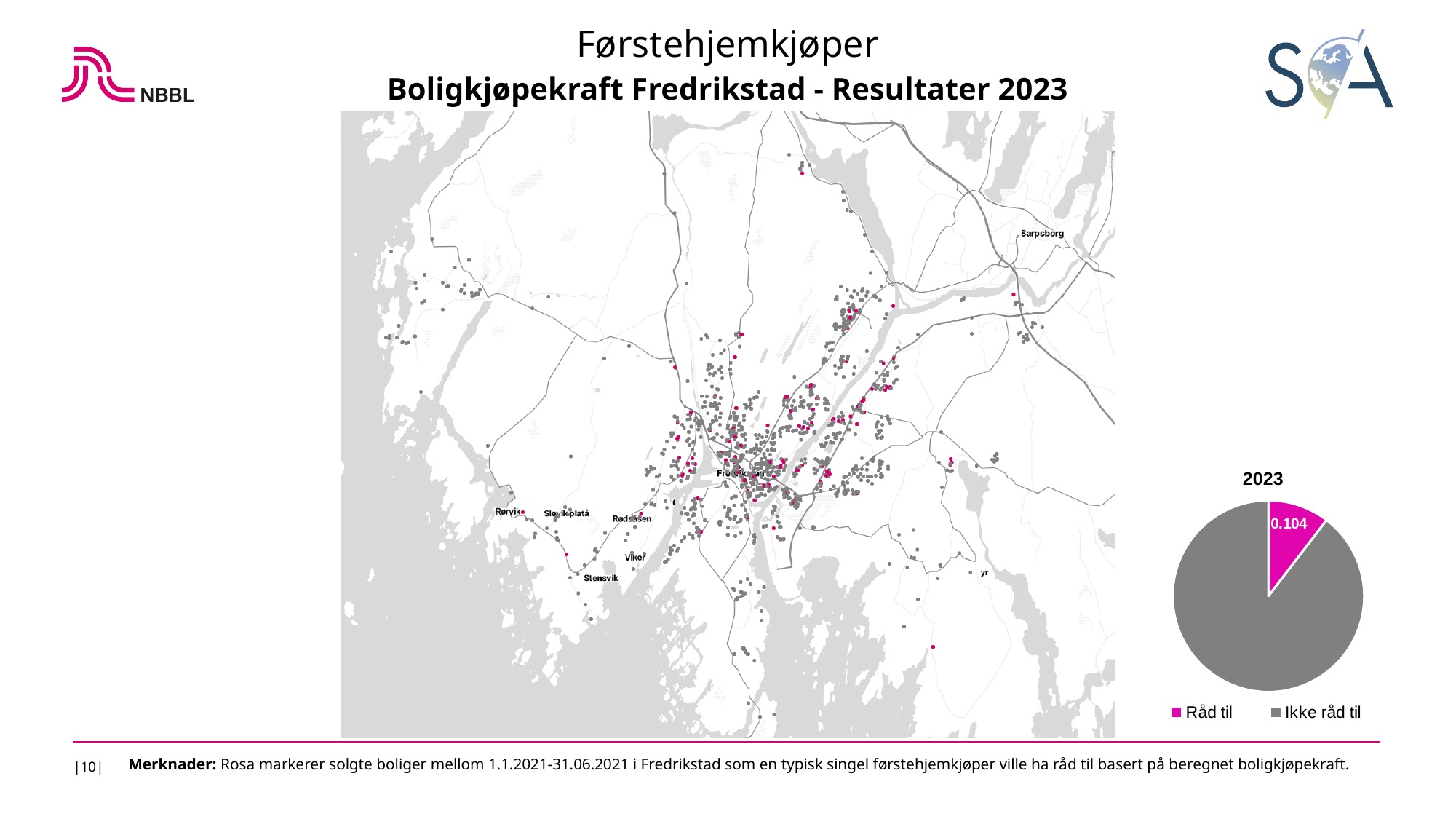
Which slice of the pie chart is the smallest? Råd til What share of the pie chart does the 'Råd til' slice represent, as labelled? 0.104 How many categories does the pie chart's legend list? 2 What kind of chart is shown on the right side of the slide? pie chart In the pie chart, which is larger: 'Råd til' or 'Ikke råd til'? Ikke råd til Which slice of the pie chart is the largest? Ikke råd til What is the title of the pie chart? 2023 What colour is the 'Råd til' slice in the pie chart? pink What value is printed on the 'Råd til' slice of the pie chart? 0.104